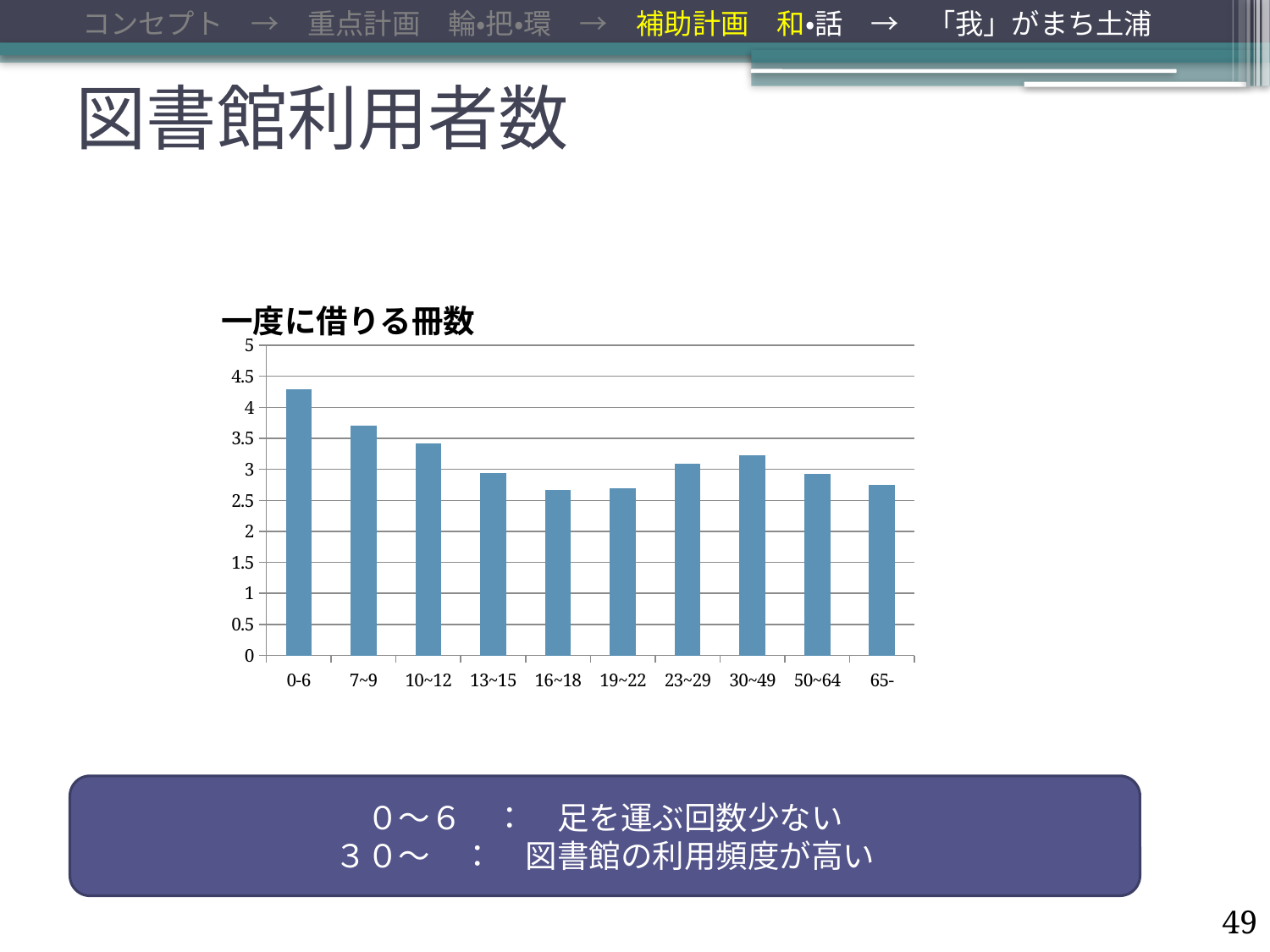
Is the value for 16~18 greater or less than 3? less Is the value for 30~49 greater or less than 3? greater Which age category has the highest value in the chart? 0-6 What is the title of the chart? 一度に借りる冊数 Is the value for 65- greater or less than 3? less How many age categories are shown on the x axis of the chart? 10 Which has the larger value, 30~49 or 50~64? 30~49 What kind of chart is shown on the slide? bar chart Do the values rise or fall from 0-6 to 16~18 along the x axis? fall Which has the larger value, 0-6 or 7~9? 0-6